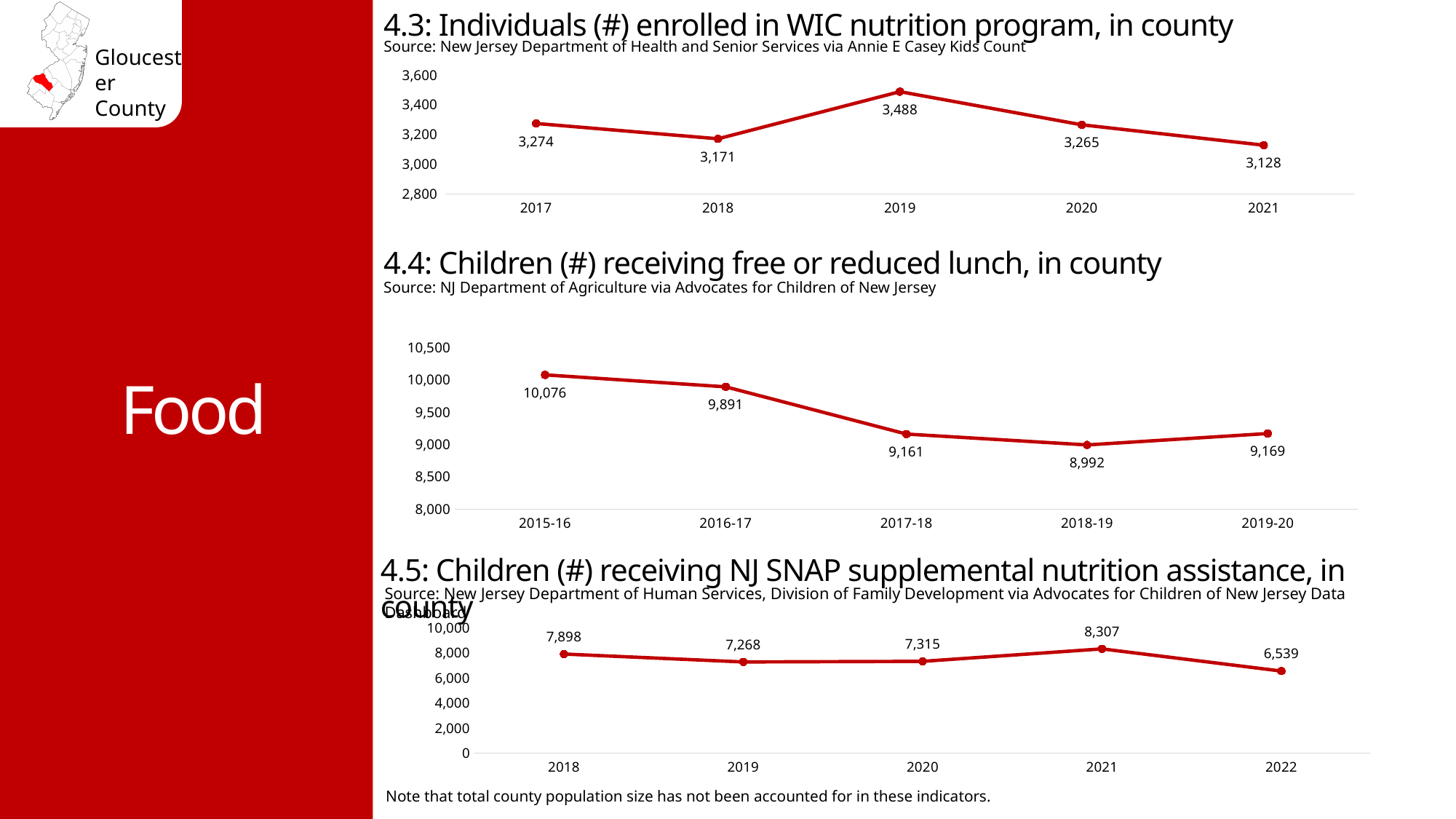
In the chart '4.5: Children (#) receiving NJ SNAP supplemental nutrition assistance, in county', what is the difference between the 2021 and 2022 values? 1,768 In the chart '4.3: Individuals (#) enrolled in WIC nutrition program, in county', what is the difference between the 2019 and 2018 values? 317 In the chart '4.5: Children (#) receiving NJ SNAP supplemental nutrition assistance, in county', which year has the lowest value? 2022 In the chart '4.3: Individuals (#) enrolled in WIC nutrition program, in county', what is the value for 2019? 3,488 In the chart '4.3: Individuals (#) enrolled in WIC nutrition program, in county', how many years are plotted? 5 In the chart '4.4: Children (#) receiving free or reduced lunch, in county', is the value for 2016-17 larger or smaller than the value for 2017-18? larger In the chart '4.3: Individuals (#) enrolled in WIC nutrition program, in county', which year has the lowest value? 2021 In the chart '4.4: Children (#) receiving free or reduced lunch, in county', do the values generally rise or fall from 2015-16 to 2018-19? fall What type of chart is '4.5: Children (#) receiving NJ SNAP supplemental nutrition assistance, in county'? line chart In the chart '4.4: Children (#) receiving free or reduced lunch, in county', which school year has the highest value? 2015-16 In the chart '4.5: Children (#) receiving NJ SNAP supplemental nutrition assistance, in county', what is the value for 2021? 8,307 In the chart '4.4: Children (#) receiving free or reduced lunch, in county', what is the value for 2018-19? 8,992